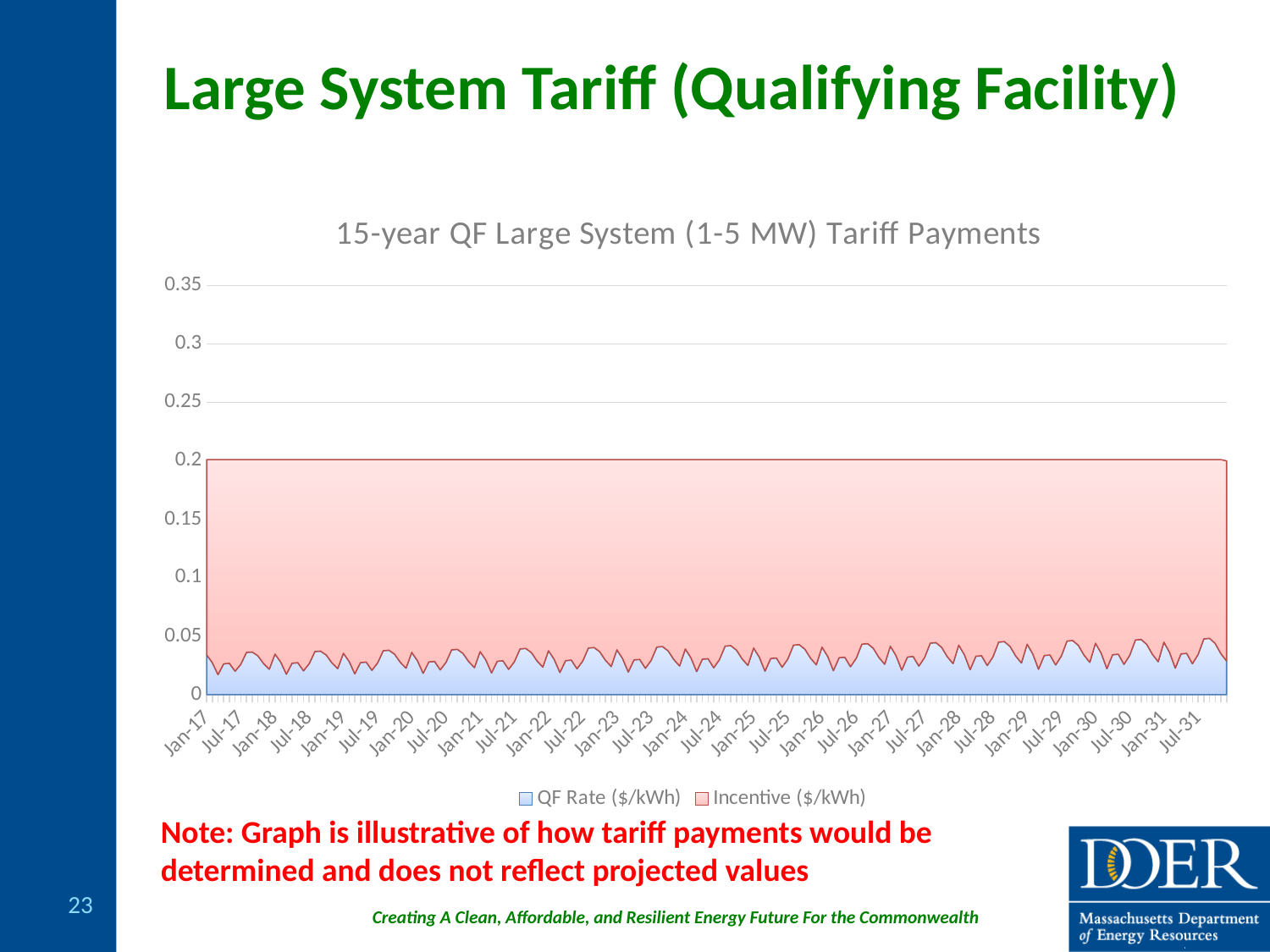
Is the combined total of QF Rate and Incentive in Jan-20 greater or less than 0.15? greater What is the first label on the horizontal axis? Jan-17 Which two series are listed in the chart legend? QF Rate ($/kWh) and Incentive ($/kWh) How many series does the chart legend list? 2 Which series makes up the larger portion of the stacked area, QF Rate ($/kWh) or Incentive ($/kWh)? Incentive ($/kWh) Is the QF Rate ($/kWh) value in Jan-17 greater or less than 0.05? less Does the combined total of the two series rise, fall, or stay flat from Jan-17 to Jul-31? Stays flat What is the last label on the horizontal axis? Jul-31 Is the combined total of QF Rate and Incentive in Jul-25 greater or less than 0.25? less What kind of chart is shown on the slide? Area chart What is the title of the chart? 15-year QF Large System (1-5 MW) Tariff Payments What is the highest value shown on the vertical axis? 0.35